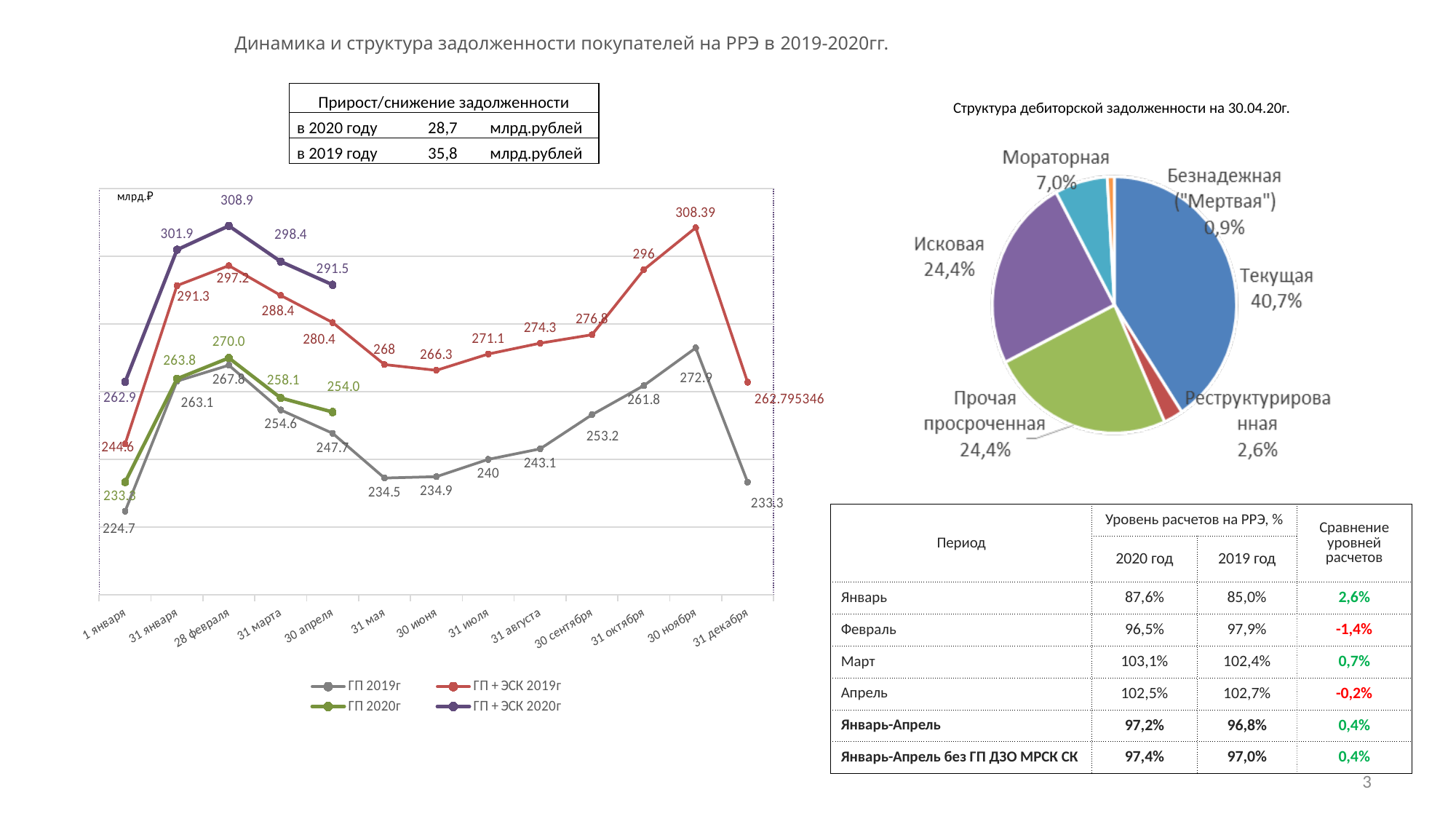
In the line chart on the left, what is the difference between the ГП + ЭСК 2020г and ГП + ЭСК 2019г values on 31 января? 10.6 How many series does the legend of the line chart on the left list? 4 What type of chart is the chart on the left of the slide? Line chart In the pie chart 'Структура дебиторской задолженности на 30.04.20г.', what share does Текущая have? 40,7% In the pie chart 'Структура дебиторской задолженности на 30.04.20г.', which category has the smallest share? Безнадежная ("Мертвая") In the line chart on the left, what is the value of the ГП 2019г series on 30 ноября? 272.9 In the line chart on the left, what is the value of the ГП 2020г series on 30 апреля? 254.0 How many slices does the pie chart 'Структура дебиторской задолженности на 30.04.20г.' have? 6 In the line chart on the left, on which date does the ГП + ЭСК 2019г series reach its highest value? 30 ноября In the line chart on the left, on which date is the ГП 2019г series at its lowest value? 1 января In the line chart on the left, what is the value of the ГП + ЭСК 2020г series on 28 февраля? 308.9 In the line chart on the left, which is larger on 31 марта: ГП 2020г or ГП 2019г? ГП 2020г